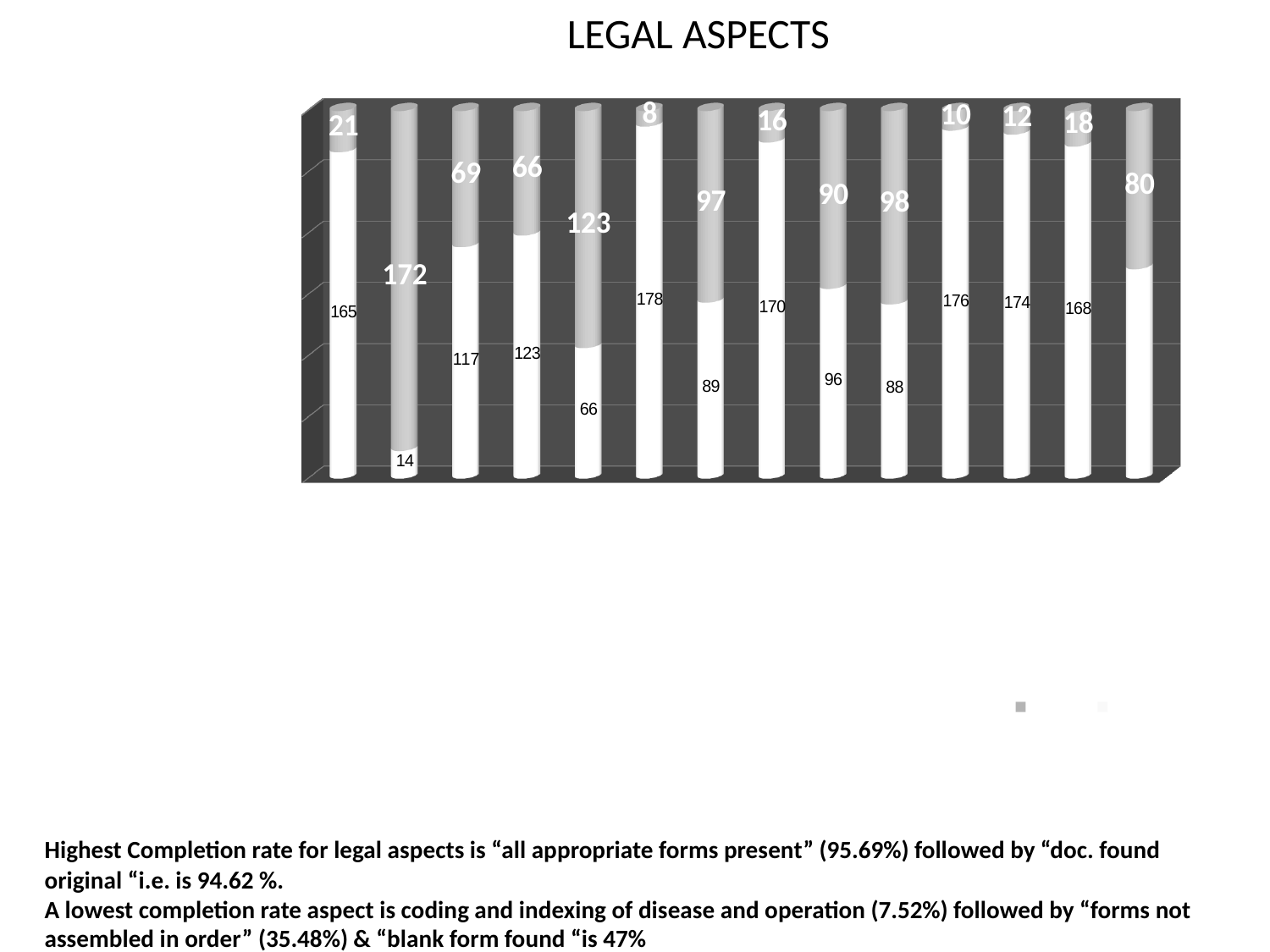
What is the value of the white (lower) segment of the first bar from the left? 165 What is the value of the grey (upper) segment of the second bar from the left? 172 Which is larger: the grey segment of the fifth bar from the left or the grey segment of the fourth bar from the left? the fifth bar (123) Which bar has the smallest white (lower) segment value? the second bar from the left (14) What is the difference between the white segment of the sixth bar (178) and the white segment of the second bar (14)? 164 What type of chart is shown on the slide? stacked bar chart How many bars are plotted in the chart? 14 What is the value of the white (lower) segment of the sixth bar from the left? 178 Which bar has the largest white (lower) segment value? the sixth bar from the left (178) What is the value of the grey (upper) segment of the last bar on the right? 80 What is the total of the first bar from the left (165 + 21)? 186 What is the title of the chart? LEGAL ASPECTS